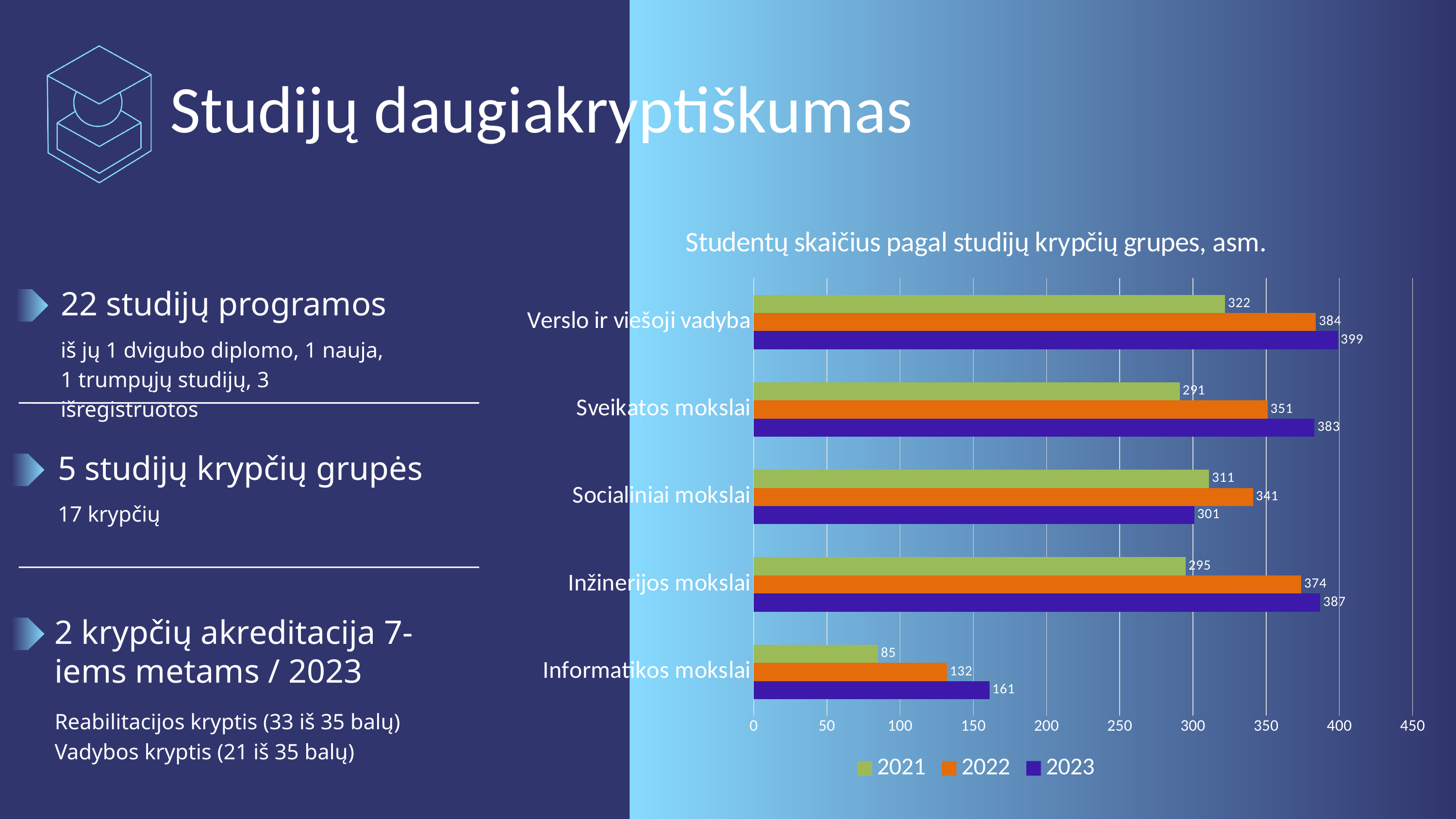
What is the title of the chart? Studentų skaičius pagal studijų krypčių grupes, asm. Which series is shown in orange? 2022 What is the 2021 value for Informatikos mokslai? 85 How many categories are shown on the chart? 5 Which category has the lowest 2021 value? Informatikos mokslai Which category has the highest 2023 value? Verslo ir viešoji vadyba What is the 2023 value for Verslo ir viešoji vadyba? 399 What is the 2022 value for Sveikatos mokslai? 351 What is the difference between the 2023 and 2021 values for Inžinerijos mokslai? 92 How many series does the legend list? 3 What kind of chart is shown on the slide? bar chart Which is larger for Socialiniai mokslai: the 2022 value or the 2023 value? 2022